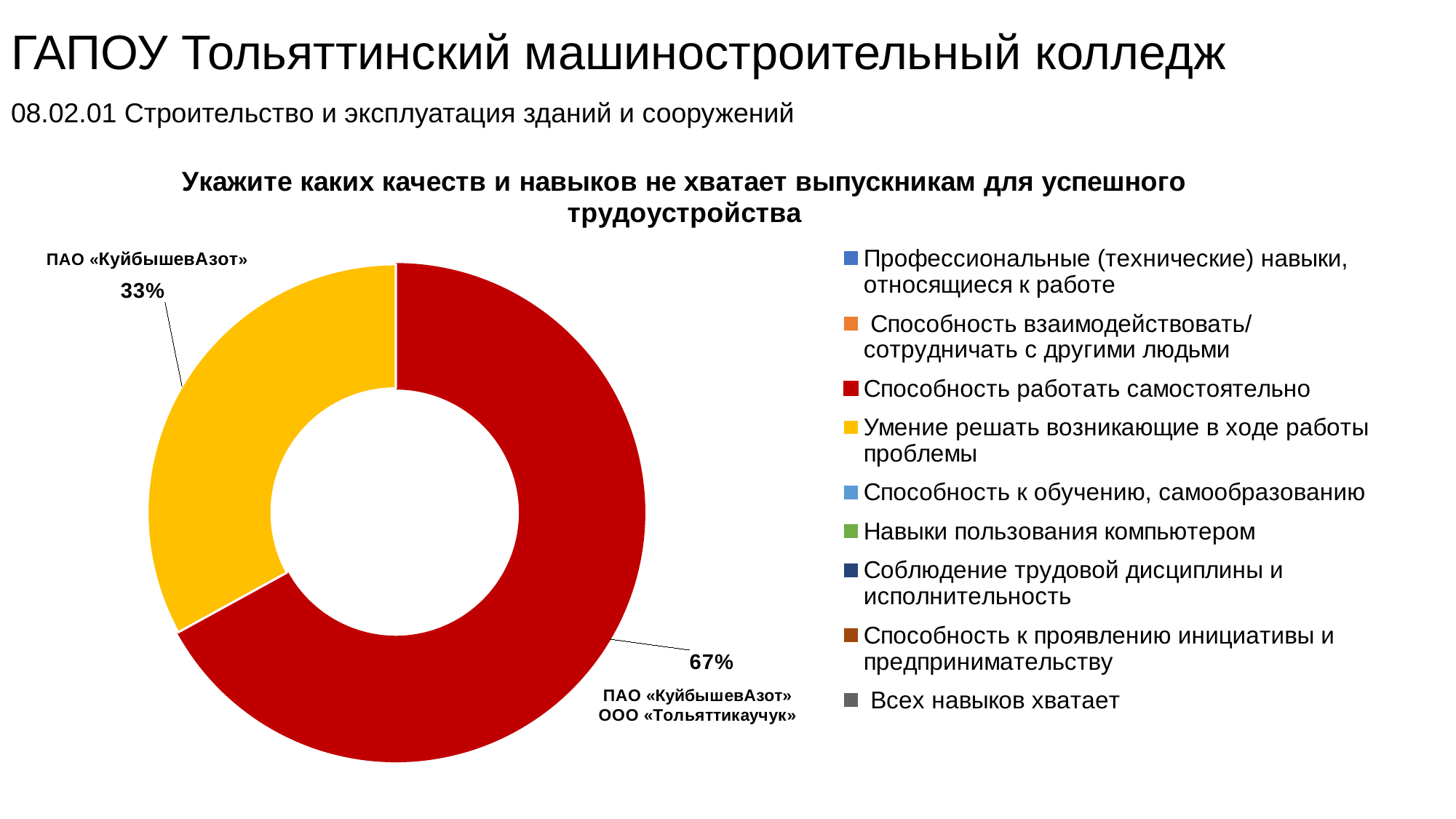
Which employers are labelled next to the 67% slice? ПАО «КуйбышевАзот» and ООО «Тольяттикаучук» What is the title of the chart? Укажите каких качеств и навыков не хватает выпускникам для успешного трудоустройства Which is larger: the slice for "Способность работать самостоятельно" or the slice for "Умение решать возникающие в ходе работы проблемы"? Способность работать самостоятельно Which category has the largest slice in the chart? Способность работать самостоятельно What share of the chart does the yellow slice, "Умение решать возникающие в ходе работы проблемы", take? 33% How many entries does the legend list? 9 What kind of chart is shown on the slide? Doughnut (pie) chart How many slices are visible in the doughnut chart? 2 What share of the chart does the red slice, "Способность работать самостоятельно", take? 67% What is the difference in percentage points between the 67% slice and the 33% slice? 34 percentage points What is the total of the two labelled slices, 67% and 33%? 100% Which of the two visible slices is smaller? Умение решать возникающие в ходе работы проблемы